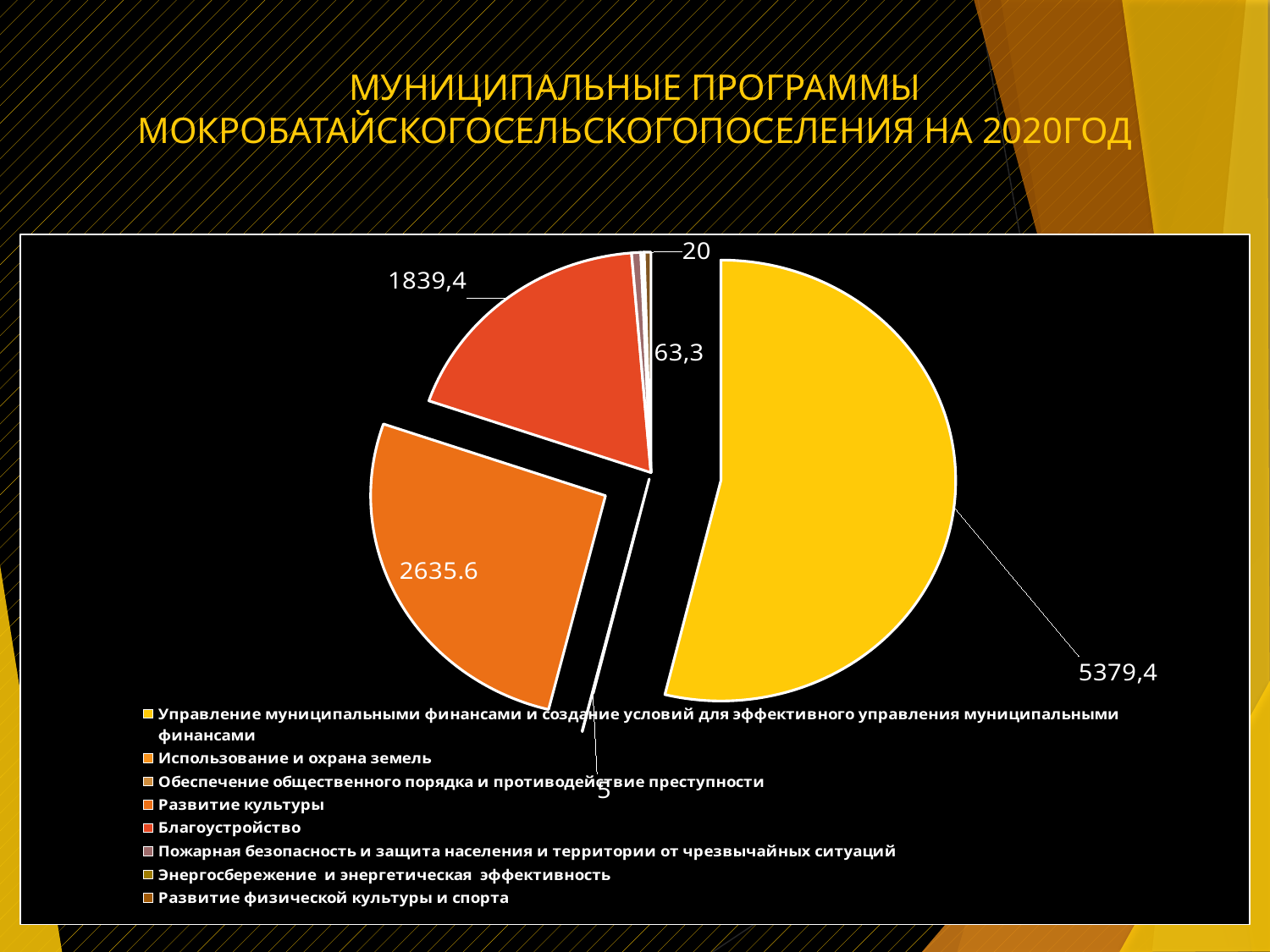
What is the difference between the slice labelled 2635.6 and the slice labelled 1839,4? 796.2 What value is labelled on the red slice in the upper left of the pie chart? 1839,4 Which is larger: the slice labelled 2635.6 or the slice labelled 1839,4? 2635.6 What kind of chart is shown on the slide? pie chart Which year does the slide title say the municipal programmes are for? 2020 What is the difference between the slice labelled 5379,4 and the slice labelled 1839,4? 3540 What is the smallest value labelled on the pie chart? 5 Which category has the largest slice in the pie chart? Управление муниципальными финансами и создание условий для эффективного управления муниципальными финансами What colour is the slice representing 'Управление муниципальными финансами и создание условий для эффективного управления муниципальными финансами'? yellow What value is labelled on the orange slice in the lower left of the pie chart? 2635.6 How many categories does the legend of the pie chart list? 8 What is the value shown for the largest (yellow) slice of the pie chart? 5379,4